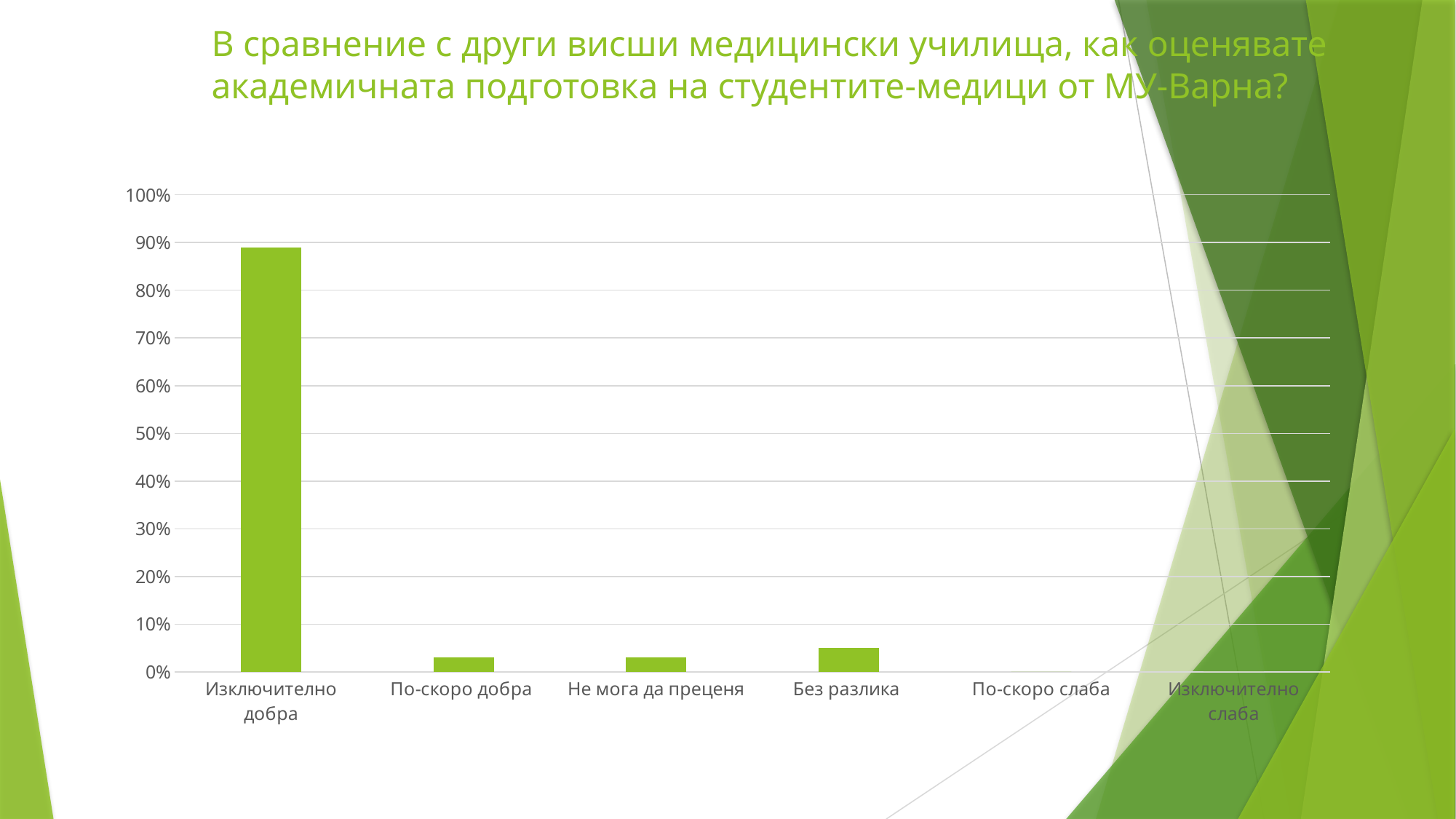
Is the value for Без разлика greater or less than 10%? less What kind of chart is shown on the slide? bar chart What is the highest value shown on the y axis of the chart? 100% How many categories are shown on the x axis of the chart? 6 Is the value for По-скоро добра greater or less than 10%? less Is the value for Не мога да преценя greater or less than 20%? less Which is larger, the value for Без разлика or the value for По-скоро добра? Без разлика Which category has the highest value in the chart? Изключително добра What colour are the bars in the chart? green Which is larger, the value for Изключително добра or the value for Без разлика? Изключително добра